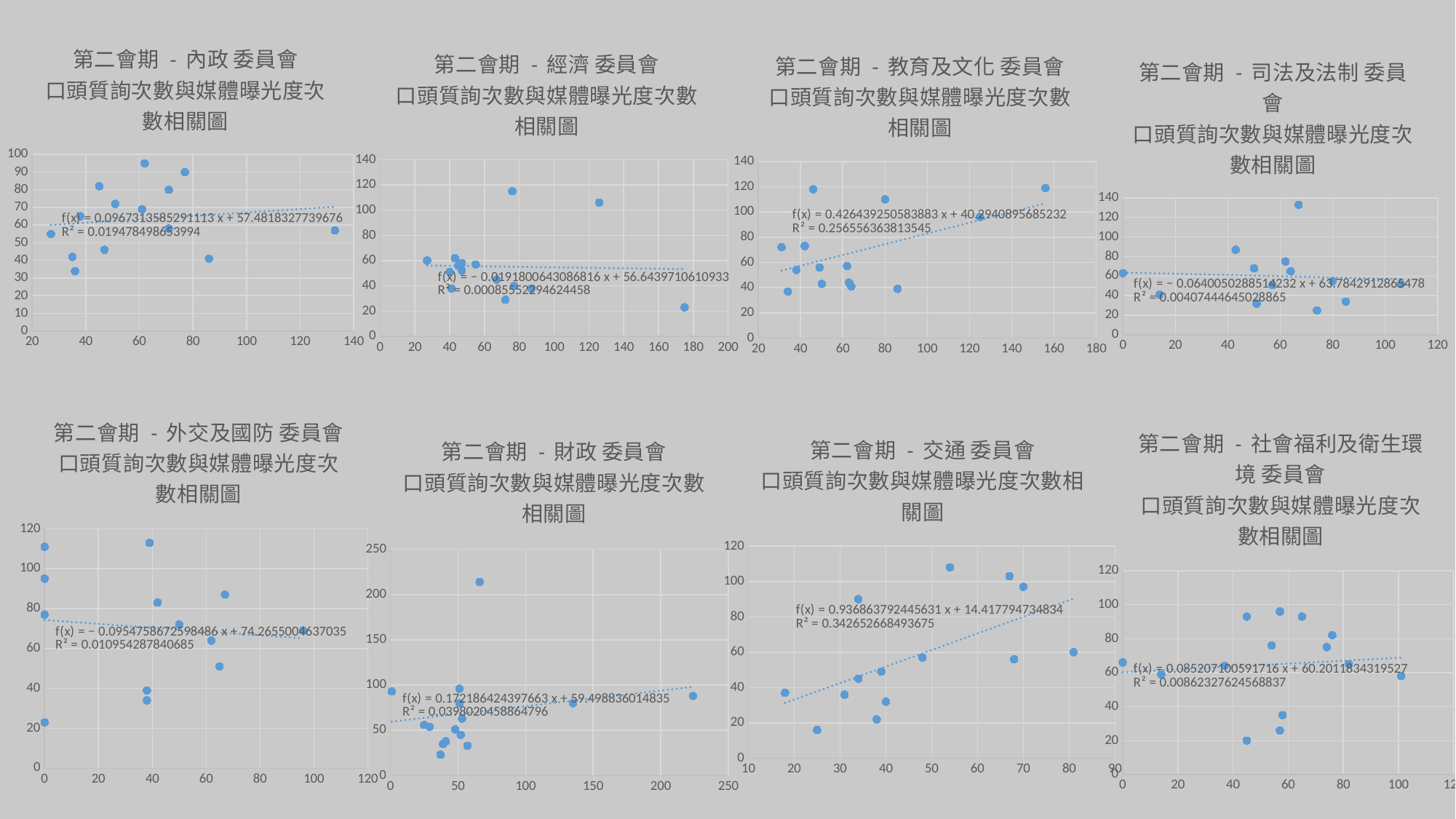
In the 第二會期 - 教育及文化 委員會 chart, does the dotted trendline rise or fall as x increases? rise In the 第二會期 - 交通 委員會 chart, is the highest plotted point greater or less than 100 on the y axis? greater How many charts are shown on the slide? 8 In the 第二會期 - 財政 委員會 chart, is the highest plotted point greater or less than 200 on the y axis? greater In the 第二會期 - 經濟 委員會 chart, does the dotted trendline rise or fall as x increases? fall In the 第二會期 - 交通 委員會 chart, does the dotted trendline rise or fall as x increases? rise In the 第二會期 - 司法及法制 委員會 chart, is the highest plotted point greater or less than 120 on the y axis? greater What kind of chart is the 第二會期 - 內政 委員會 chart? scatter chart In the 第二會期 - 財政 委員會 chart, what is the R² value printed on the chart? R² = 0.0398020458864796 In the 第二會期 - 教育及文化 委員會 chart, what is the R² value printed on the chart? R² = 0.256556363813545 In the 第二會期 - 交通 委員會 chart, what is the R² value printed on the chart? R² = 0.342652668493675